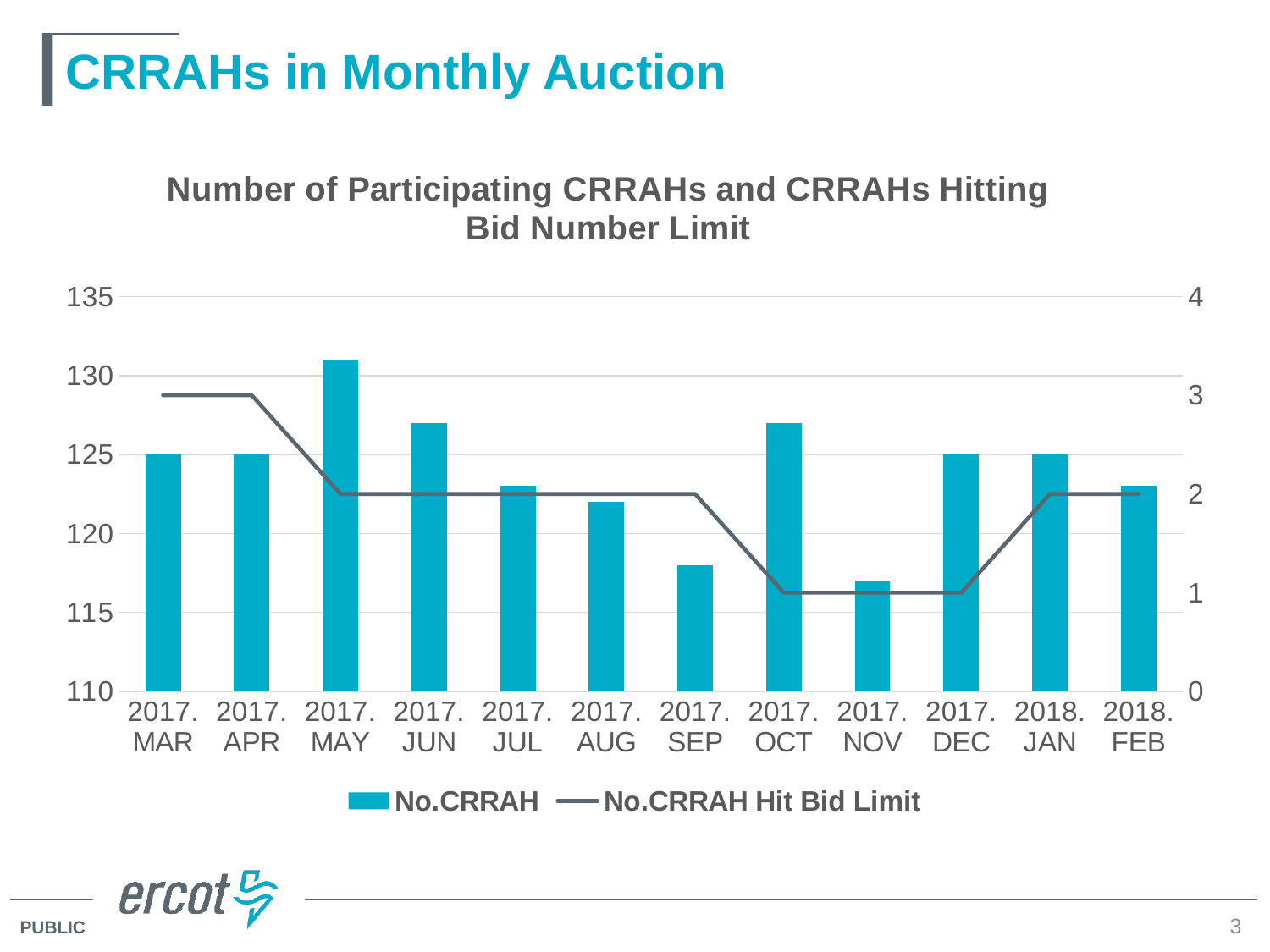
Which is larger, the No.CRRAH value for 2017.MAY or for 2017.JUN? 2017.MAY Is the No.CRRAH value for 2017.MAY greater or less than 130? greater Does the No.CRRAH Hit Bid Limit line rise or fall from 2017.APR to 2017.OCT? fall What is the value of No.CRRAH Hit Bid Limit for 2017.APR? 3 Is the No.CRRAH value for 2017.SEP greater or less than 120? less How many months are shown on the x axis? 12 What is the value of No.CRRAH Hit Bid Limit for 2018.FEB? 2 What is the value of No.CRRAH Hit Bid Limit for 2017.NOV? 1 Is the No.CRRAH value for 2017.OCT greater or less than 125? greater Which month has the highest No.CRRAH value? 2017.MAY How many series does the legend list? 2 What is the value of No.CRRAH for 2017.MAR? 125